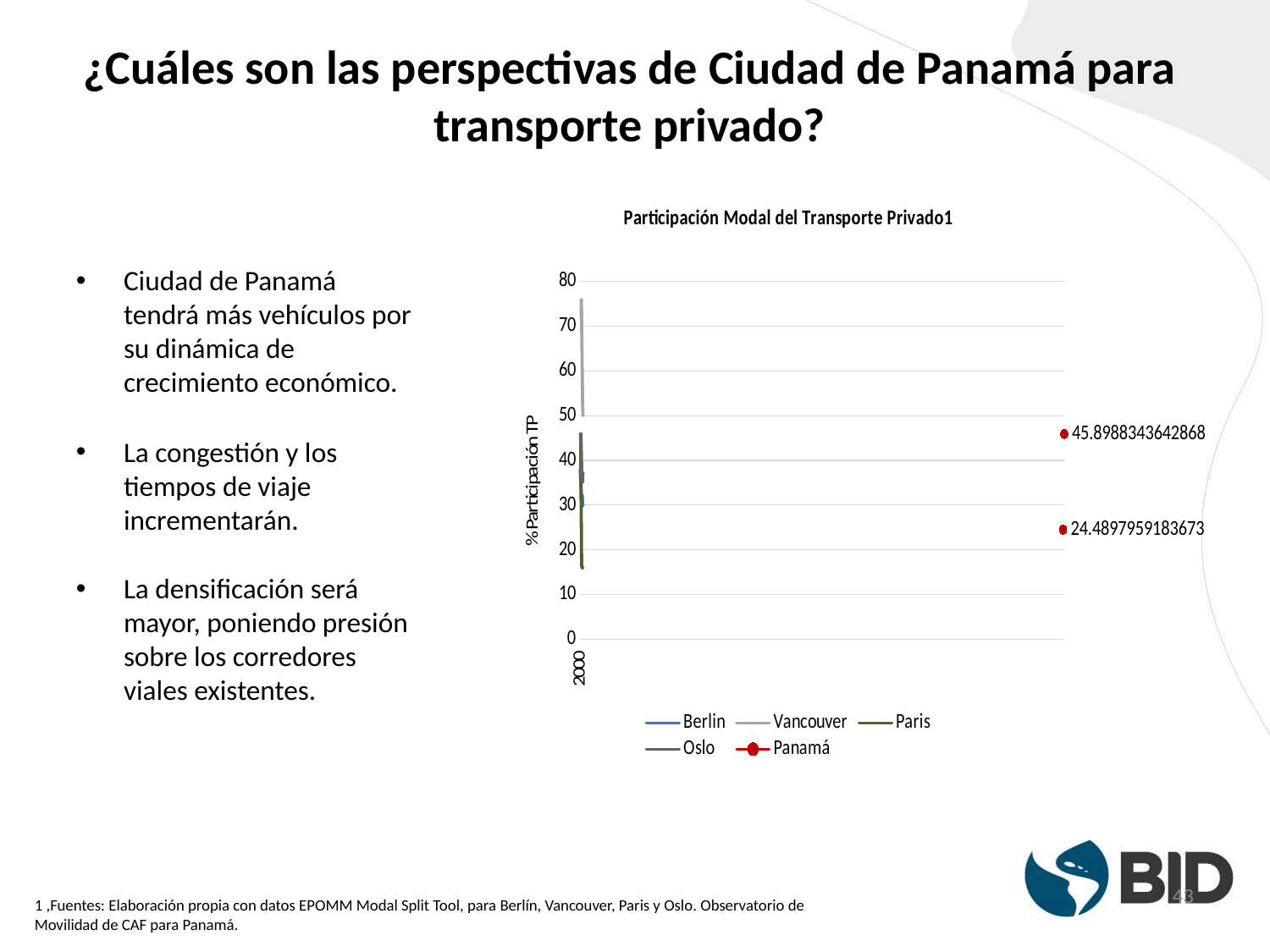
What is the lower of the two data labels shown for the Panamá series? 24.4897959183673 What is the title of the chart? Participación Modal del Transporte Privado1 Which series are listed in the chart legend? Berlin, Vancouver, Paris, Oslo, Panamá What is the highest value shown on the y axis of the chart? 80 What is the higher of the two data labels shown for the Panamá series? 45.8988343642868 How many data labels are printed on the chart? 2 Is the Panamá data label 24.4897959183673 greater or less than 30 on the y axis? less Is the Panamá data label 45.8988343642868 greater or less than 40 on the y axis? greater What kind of chart is shown on the slide? line chart Which of the two Panamá data labels is larger, 45.8988343642868 or 24.4897959183673? 45.8988343642868 What is the difference between the two Panamá data labels, 45.8988343642868 and 24.4897959183673? 21.4090384459195 How many series does the chart legend list? 5